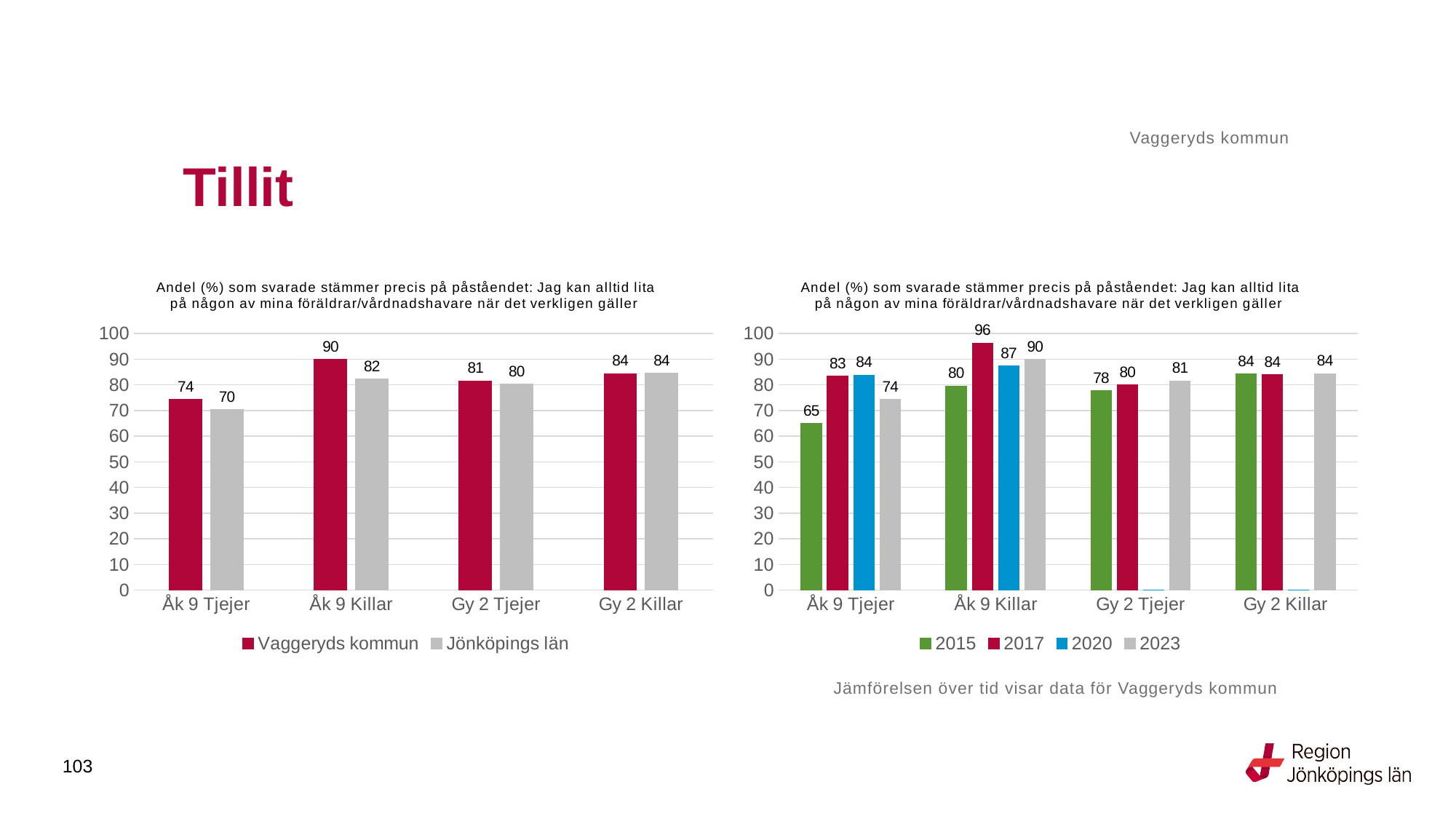
In the right chart, which is larger for Åk 9 Killar: the 2020 value or the 2023 value? 2023 In the left chart, what is the value for Jönköpings län for Åk 9 Killar? 82 In the left chart, what is the difference between Vaggeryds kommun and Jönköpings län for Åk 9 Tjejer? 4 What kind of chart is the left chart? Bar chart In the left chart, what is the value for Vaggeryds kommun for Åk 9 Tjejer? 74 In the left chart, how many series does the legend list? 2 In the right chart, what is the difference between the 2017 and 2023 values for Åk 9 Tjejer? 9 In the right chart, what is the value for 2017 for Åk 9 Killar? 96 In the right chart, how many series does the legend list? 4 In the right chart, what is the value for 2015 for Åk 9 Tjejer? 65 In the right chart, which category has the lowest value for 2015? Åk 9 Tjejer In the left chart, which category has the highest value for Vaggeryds kommun? Åk 9 Killar